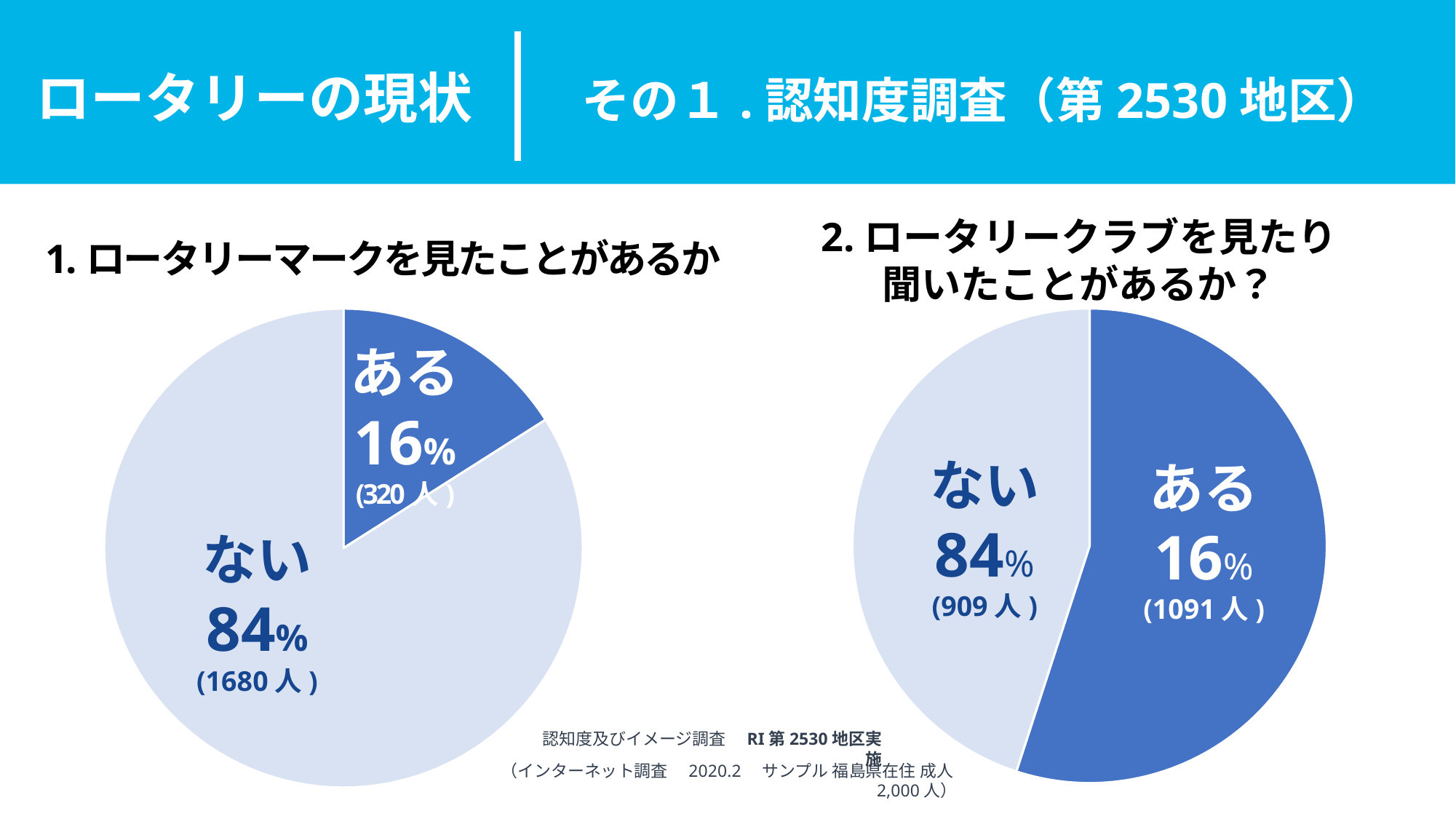
In the left pie chart "1. ロータリーマークを見たことがあるか", how many more people answered ない than ある? 1360人 In the left pie chart "1. ロータリーマークを見たことがあるか", which slice is the largest? ない In the left pie chart "1. ロータリーマークを見たことがあるか", what is the total number of people across both slices? 2000人 What is the title of the pie chart on the right side of the slide? 2. ロータリークラブを見たり聞いたことがあるか？ In the right pie chart "2. ロータリークラブを見たり聞いたことがあるか？", what percentage label is printed for ない? 84% In the right pie chart "2. ロータリークラブを見たり聞いたことがあるか？", how many people are shown for ある? 1091人 How many slices does the right pie chart "2. ロータリークラブを見たり聞いたことがあるか？" have? 2 How many slices does the left pie chart "1. ロータリーマークを見たことがあるか" have? 2 In the left pie chart "1. ロータリーマークを見たことがあるか", what percentage is shown for ある? 16% In the left pie chart "1. ロータリーマークを見たことがあるか", how many people are shown for ない? 1680人 What type of chart is used for "1. ロータリーマークを見たことがあるか" on the left? Pie chart In the right pie chart "2. ロータリークラブを見たり聞いたことがあるか？", which answer has the larger number of people printed, ある or ない? ある